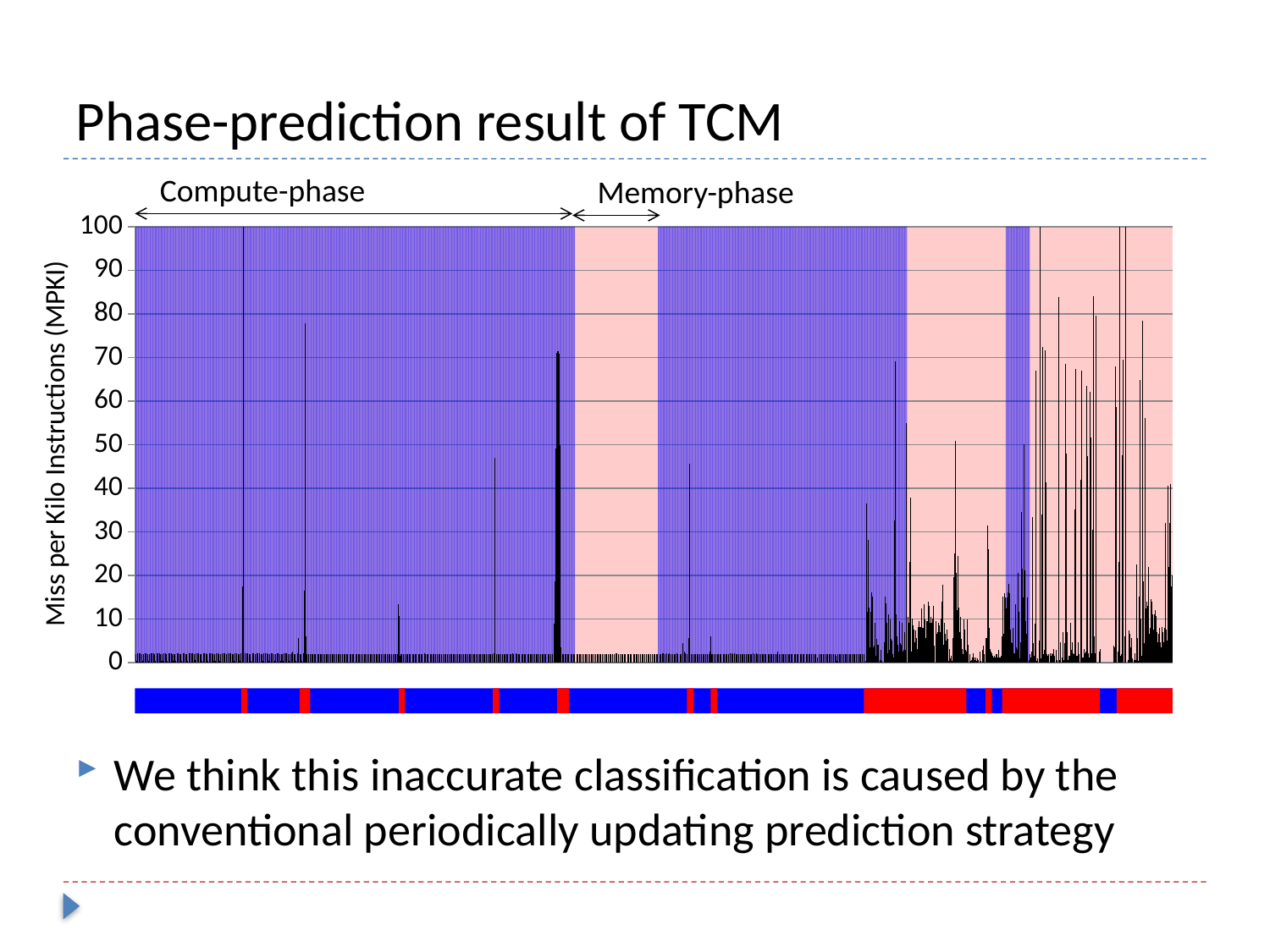
Are the MPKI values generally higher toward the left or toward the right of the chart? right What kind of chart is shown on the slide? bar chart Is the tallest spike in the Compute-phase region greater or less than 50 MPKI? greater What is the highest value marked on the y axis of the chart? 100 What is the label on the y axis of the chart? Miss per Kilo Instructions (MPKI)